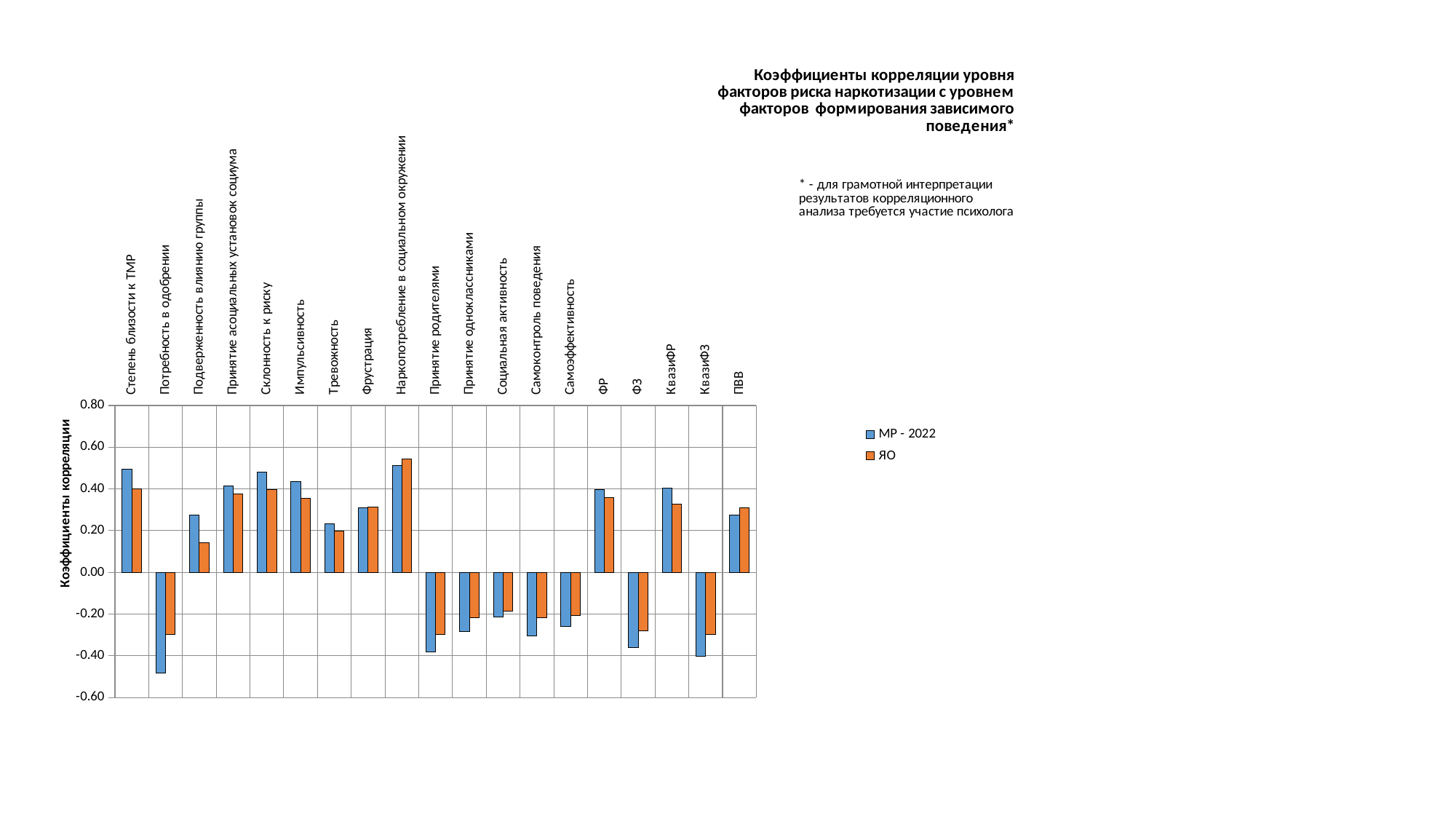
What is the title of the vertical axis? Коэффициенты корреляции How many categories are plotted along the x axis? 19 For Степень близости к ТМР, which series has the larger value, МР - 2022 or ЯО? МР - 2022 How many series does the legend list? 2 Is the ЯО value for Наркопотребление в социальном окружении greater or less than 0.40? greater Which category has the lowest value for the МР - 2022 series? Потребность в одобрении Is the МР - 2022 value for Потребность в одобрении greater or less than -0.40? less What kind of chart is shown on the slide? bar chart For Подверженность влиянию группы, which series has the larger value, МР - 2022 or ЯО? МР - 2022 Is the МР - 2022 value for Принятие родителями greater or less than -0.20? less Which category has the highest value for the ЯО series? Наркопотребление в социальном окружении